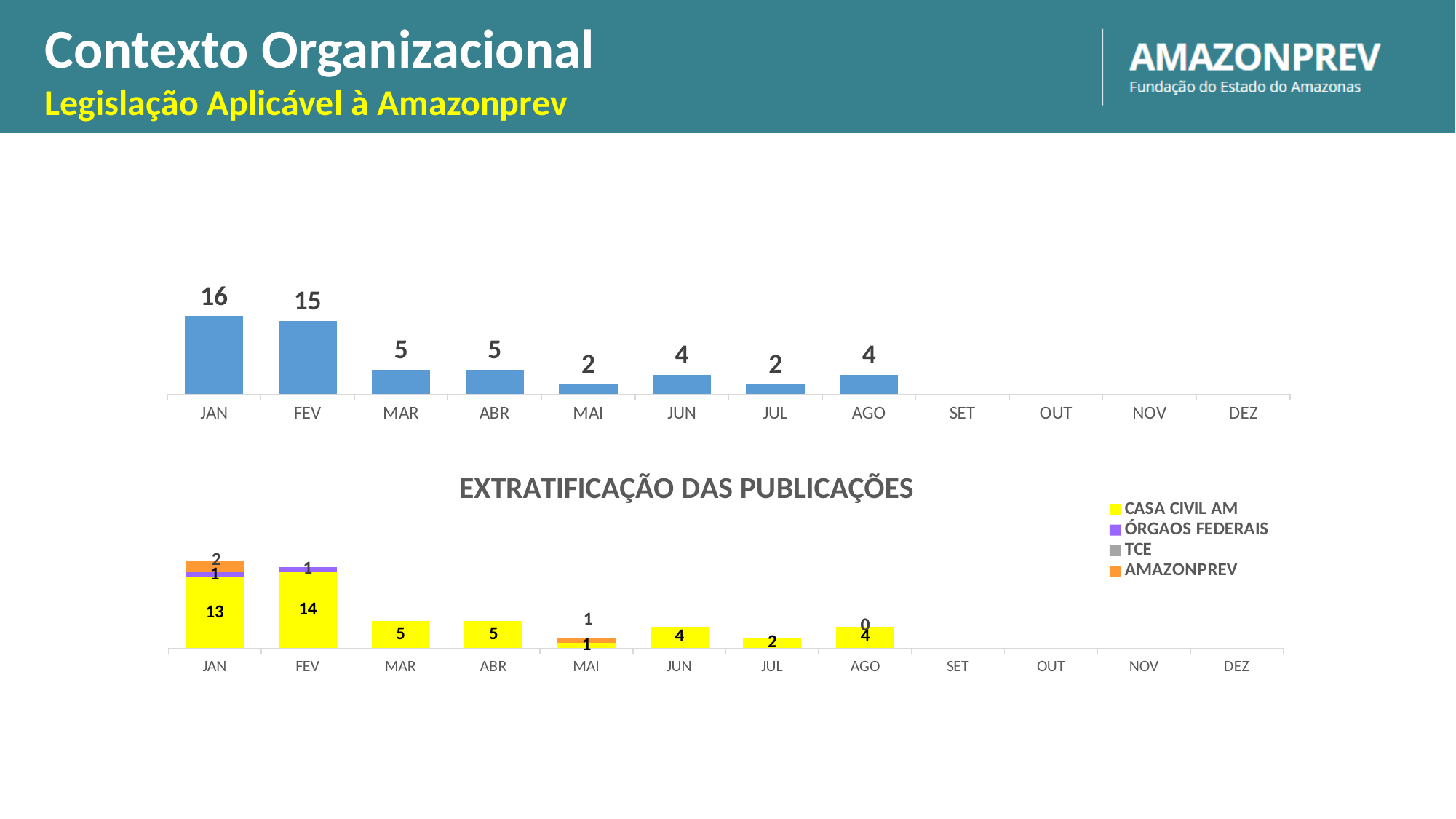
In the chart titled EXTRATIFICAÇÃO DAS PUBLICAÇÕES, what is the CASA CIVIL AM value for FEV? 14 In the chart titled EXTRATIFICAÇÃO DAS PUBLICAÇÕES, which series is shown in orange? AMAZONPREV In the top chart, which month has the highest value? JAN What kind of chart is the top chart? bar chart In the chart titled EXTRATIFICAÇÃO DAS PUBLICAÇÕES, what is the total of the stacked bar for JAN? 16 In the chart titled EXTRATIFICAÇÃO DAS PUBLICAÇÕES, how many series does the legend list? 4 In the top chart, do the values generally rise or fall from JAN to AGO? fall In the top chart, which is larger, the value for JUN or the value for JUL? JUN In the top chart, what is the difference between the values for JAN and MAR? 11 In the top chart, how many months have a bar plotted? 8 In the top chart, what is the value for FEV? 15 In the top chart, what is the value for JAN? 16